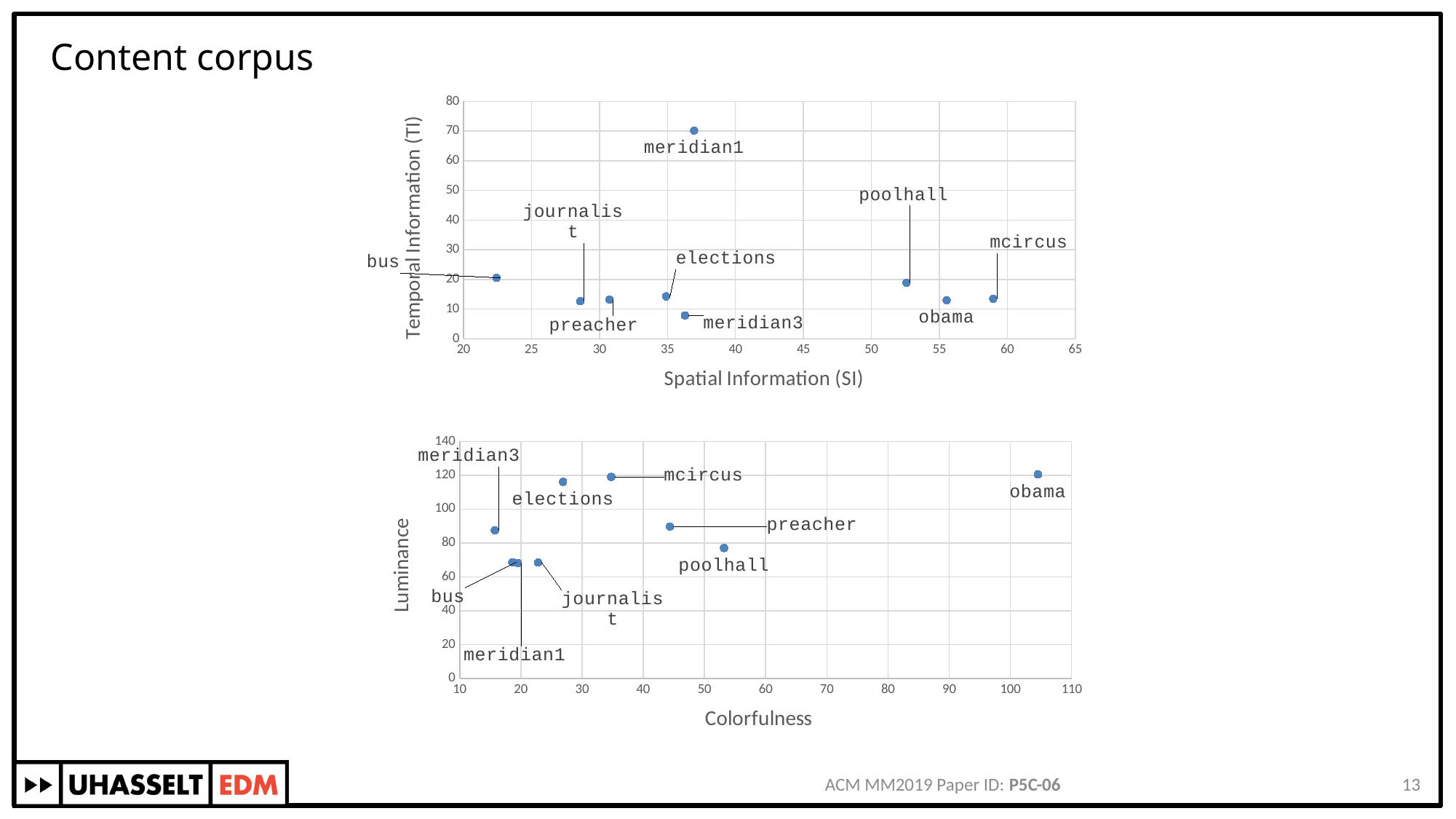
In the bottom chart (Colorfulness vs Luminance), which content has the highest Colorfulness? obama In the top chart (Spatial Information vs Temporal Information), which content has the highest Temporal Information (TI)? meridian1 In the top chart (Spatial Information vs Temporal Information), which has the higher Spatial Information, mcircus or obama? mcircus In the top chart (Spatial Information vs Temporal Information), which content has the lowest Temporal Information (TI)? meridian3 In the bottom chart (Colorfulness vs Luminance), is the Colorfulness value for obama greater or less than 100? greater In the top chart (Spatial Information vs Temporal Information), is the Spatial Information value for bus greater or less than 25? less In the bottom chart (Colorfulness vs Luminance), which content has the lowest Colorfulness? meridian3 In the top chart (Spatial Information vs Temporal Information), how many labelled data points are plotted? 9 What is the x-axis title of the bottom chart? Colorfulness What kind of chart is the top chart (Spatial Information vs Temporal Information)? scatter chart In the bottom chart (Colorfulness vs Luminance), which has the higher Luminance, preacher or poolhall? preacher In the top chart (Spatial Information vs Temporal Information), is the Temporal Information value for meridian1 greater or less than 60? greater